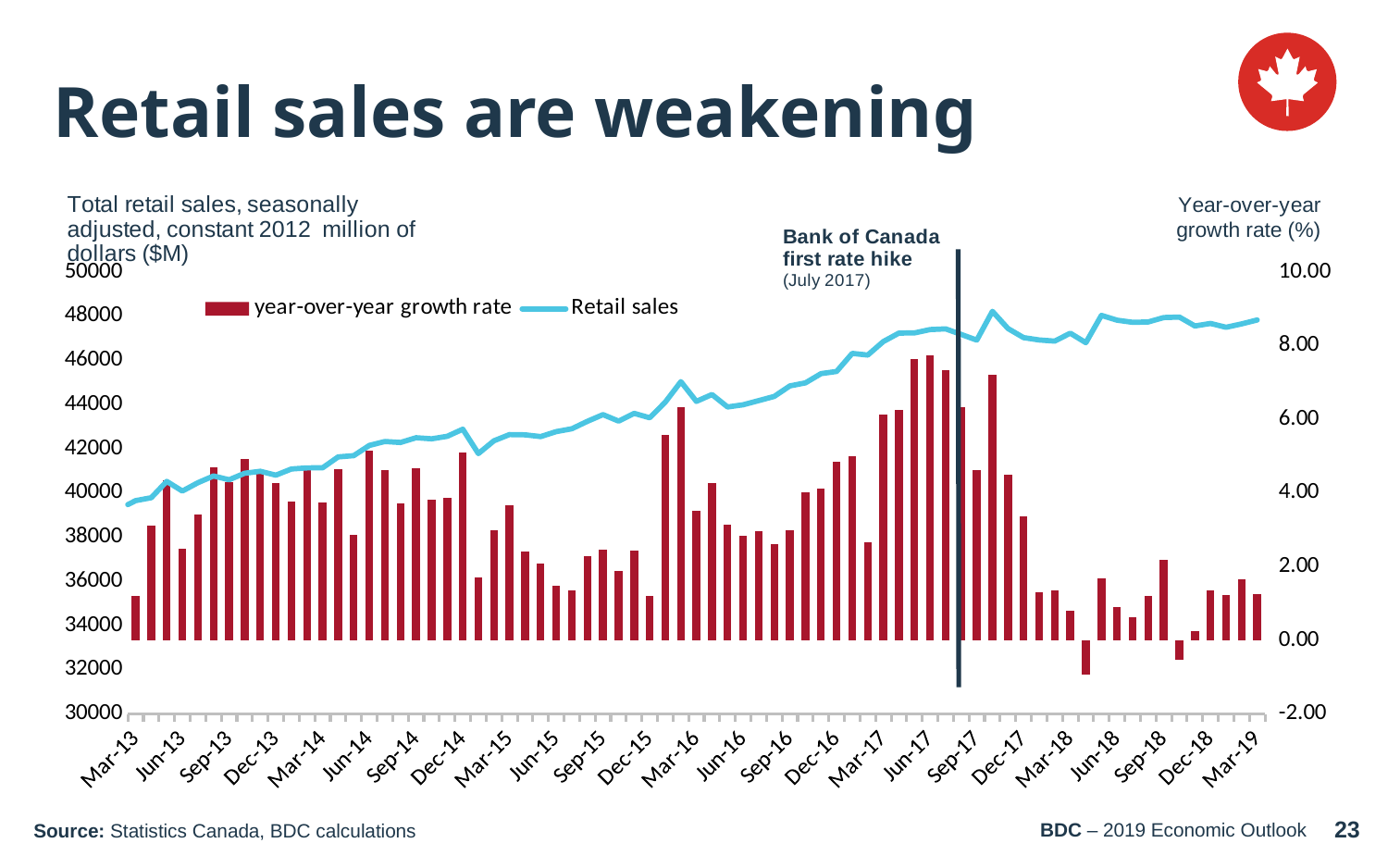
What event does the vertical line on the chart mark? Bank of Canada first rate hike (July 2017) Does the Retail sales line generally rise or fall from Mar-13 to Mar-19? Rise Is the year-over-year growth rate at Mar-19 greater or less than 2.00? less What kind of chart is shown on the slide? A combined bar and line chart Is the year-over-year growth rate at Jun-17 greater or less than 6.00? greater Which is larger, the year-over-year growth rate at Jun-17 or at Mar-19? Jun-17 Which is larger, the Retail sales value at Mar-13 or at Mar-19? Mar-19 Which series is drawn as bars in the chart? year-over-year growth rate Is the Retail sales value at Sep-17 greater or less than 46000? greater How many series does the chart legend list? 2